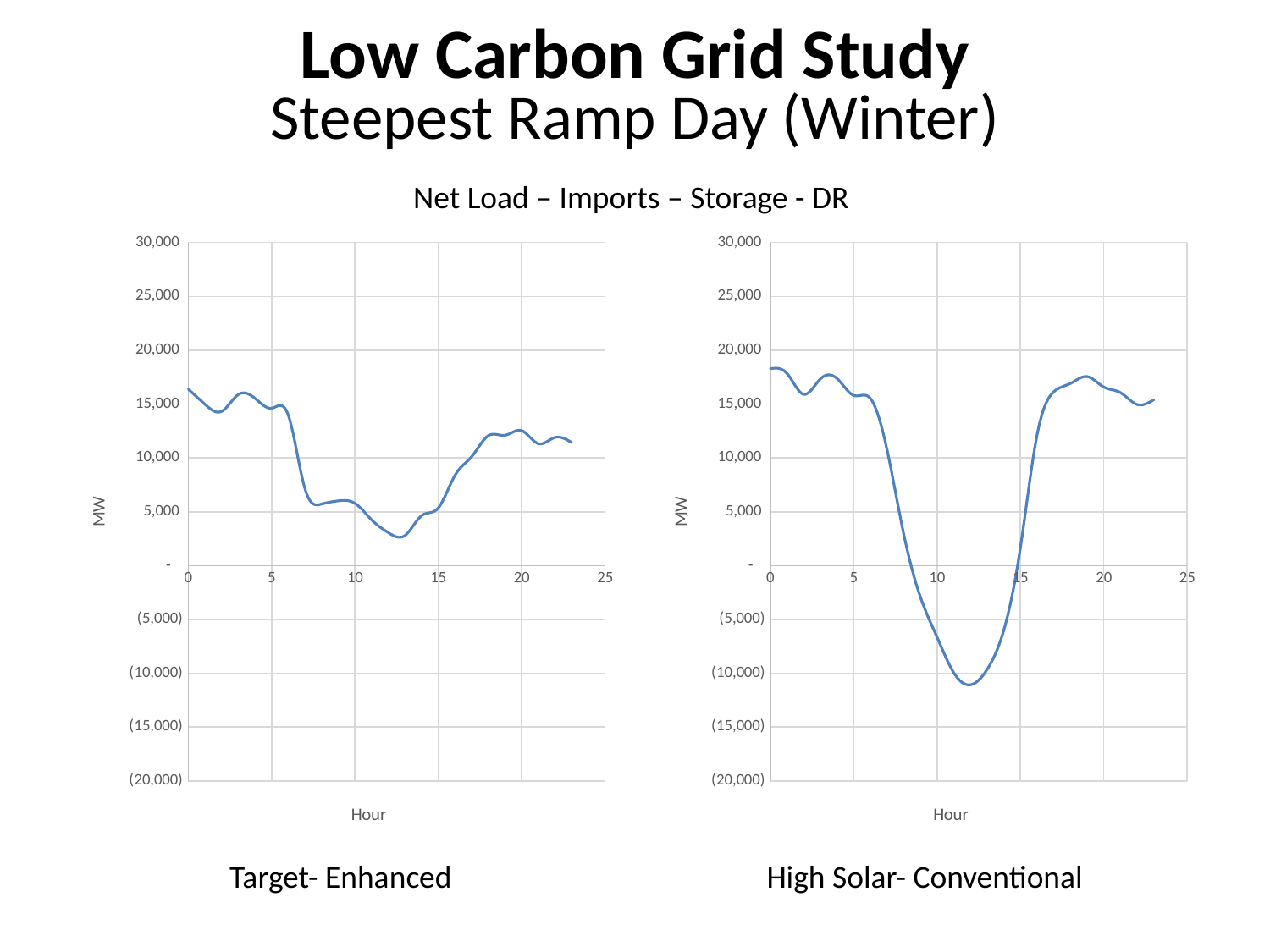
In the Target- Enhanced chart, is the value at hour 0 greater or less than 15,000? greater In the Target- Enhanced chart, is the lowest value of the line greater or less than 5,000? less In the High Solar- Conventional chart, does the line rise or fall between hour 5 and hour 12? fall In the High Solar- Conventional chart, is the value at hour 0 greater or less than 15,000? greater In the Target- Enhanced chart, does the line rise or fall between hour 13 and hour 18? rise What is the y-axis label on both charts? MW Which chart reaches a lower minimum value, Target- Enhanced or High Solar- Conventional? High Solar- Conventional What kind of chart is the Target- Enhanced chart on the left? line chart What is the x-axis label on both charts? Hour